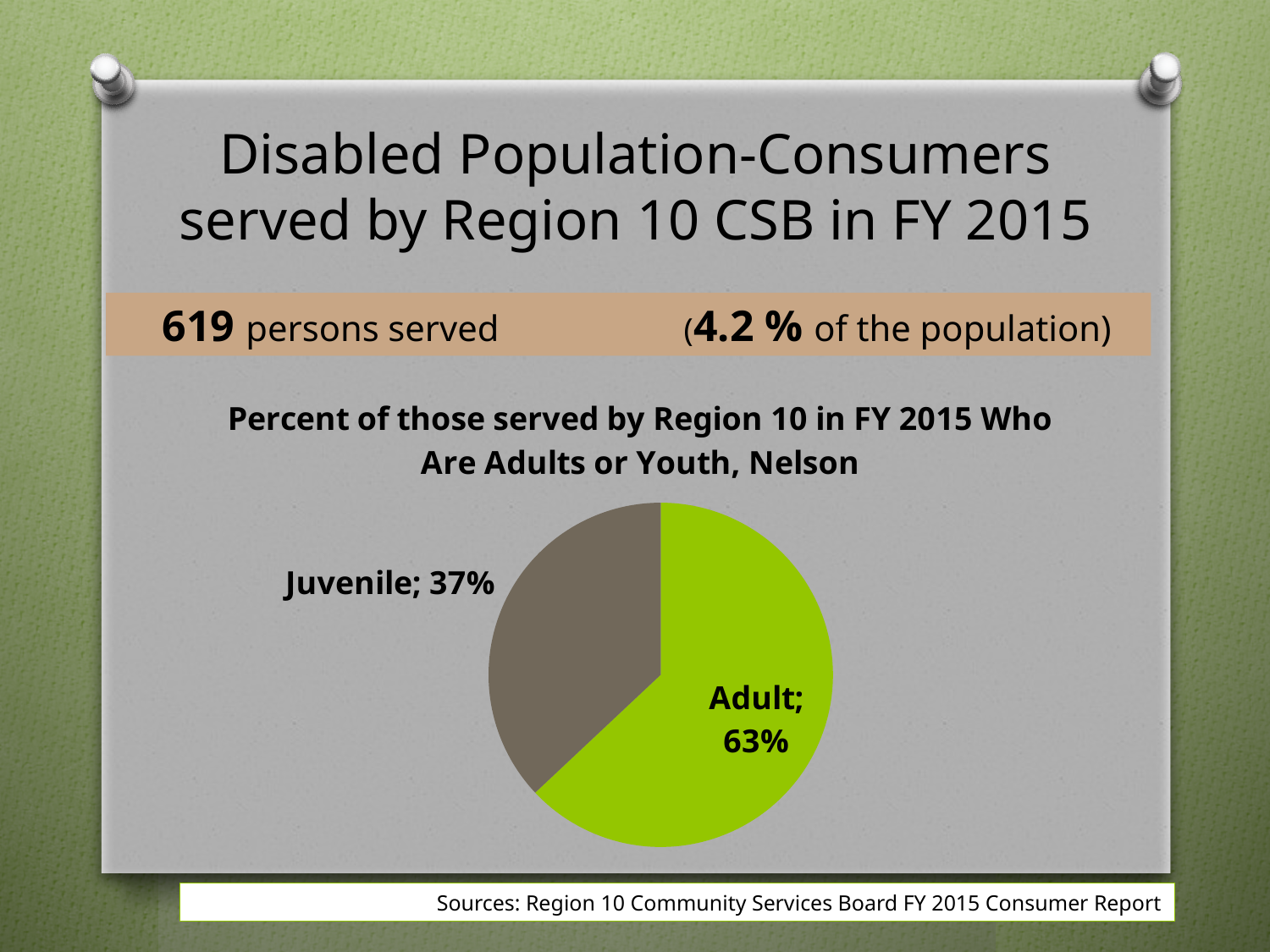
What is the title of the pie chart? Percent of those served by Region 10 in FY 2015 Who Are Adults or Youth, Nelson Which category has the smallest share of the pie? Juvenile Is the Juvenile share greater or less than 50%? less What colour is the Adult slice of the pie chart? Green What percentage of those served are Juvenile? 37% How many slices does the pie chart have? 2 What is the difference in percentage points between the Adult and Juvenile shares? 26 What kind of chart is shown on the slide? Pie chart Which is larger, the Adult share or the Juvenile share? Adult What percentage of those served are Adults? 63% Which category has the largest share of the pie? Adult